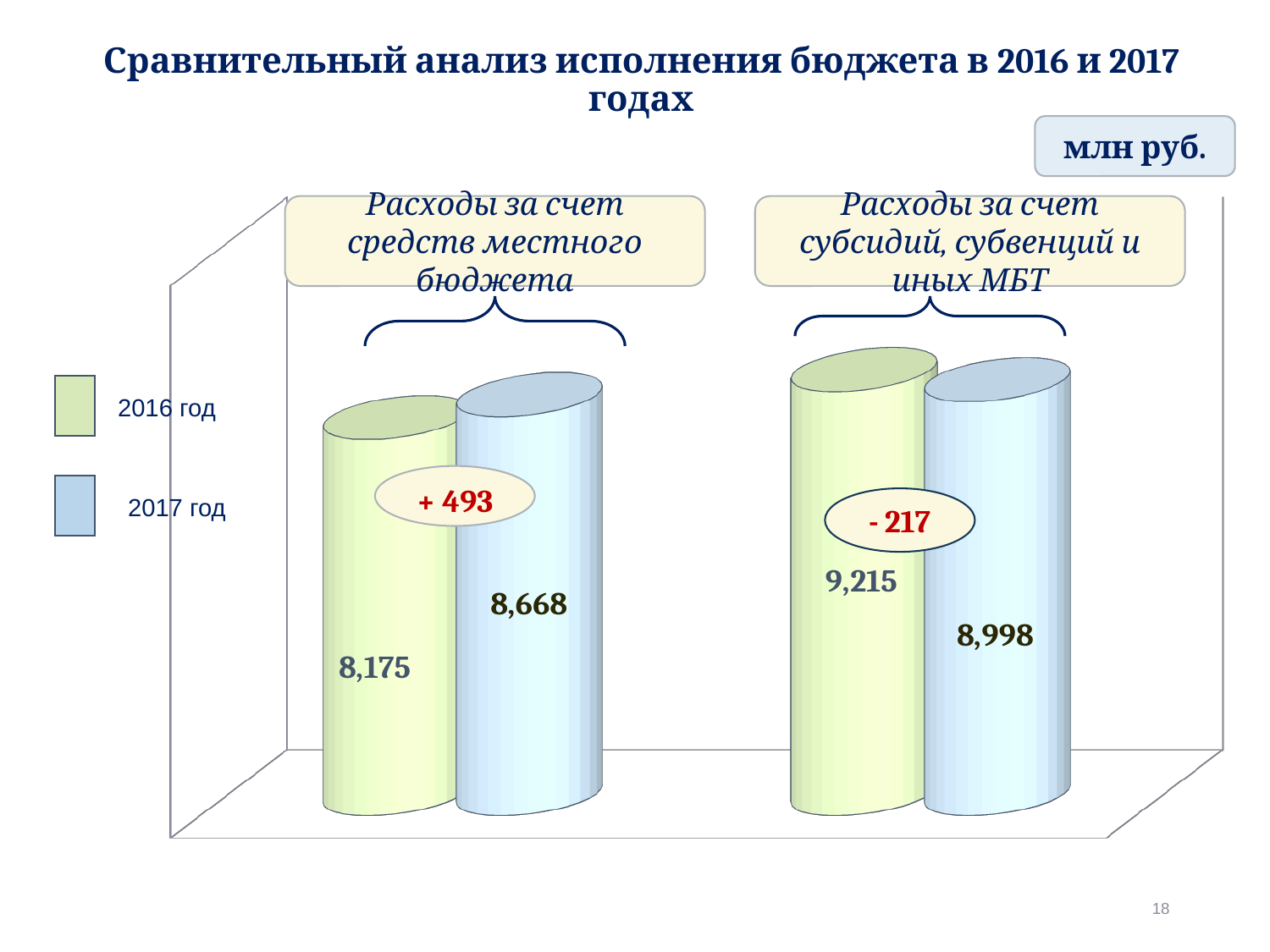
What is the difference between the 2017 год and 2016 год values for Расходы за счет субсидий, субвенций и иных МБТ, as labelled on the chart? - 217 What is the value for 2017 год for Расходы за счет средств местного бюджета? 8,668 What is the difference between the 2017 год and 2016 год values for Расходы за счет средств местного бюджета, as labelled on the chart? + 493 How many series does the legend list? 2 What is the value for 2016 год for Расходы за счет субсидий, субвенций и иных МБТ? 9,215 What unit of measurement is indicated for the chart values? млн руб. For Расходы за счет субсидий, субвенций и иных МБТ, which year has the larger value, 2016 год or 2017 год? 2016 год What is the value for 2016 год for Расходы за счет средств местного бюджета? 8,175 Which bar has the lowest value on the chart? 2016 год, Расходы за счет средств местного бюджета What kind of chart is shown on the slide? Bar chart Which bar has the highest value on the chart? 2016 год, Расходы за счет субсидий, субвенций и иных МБТ What is the value for 2017 год for Расходы за счет субсидий, субвенций и иных МБТ? 8,998